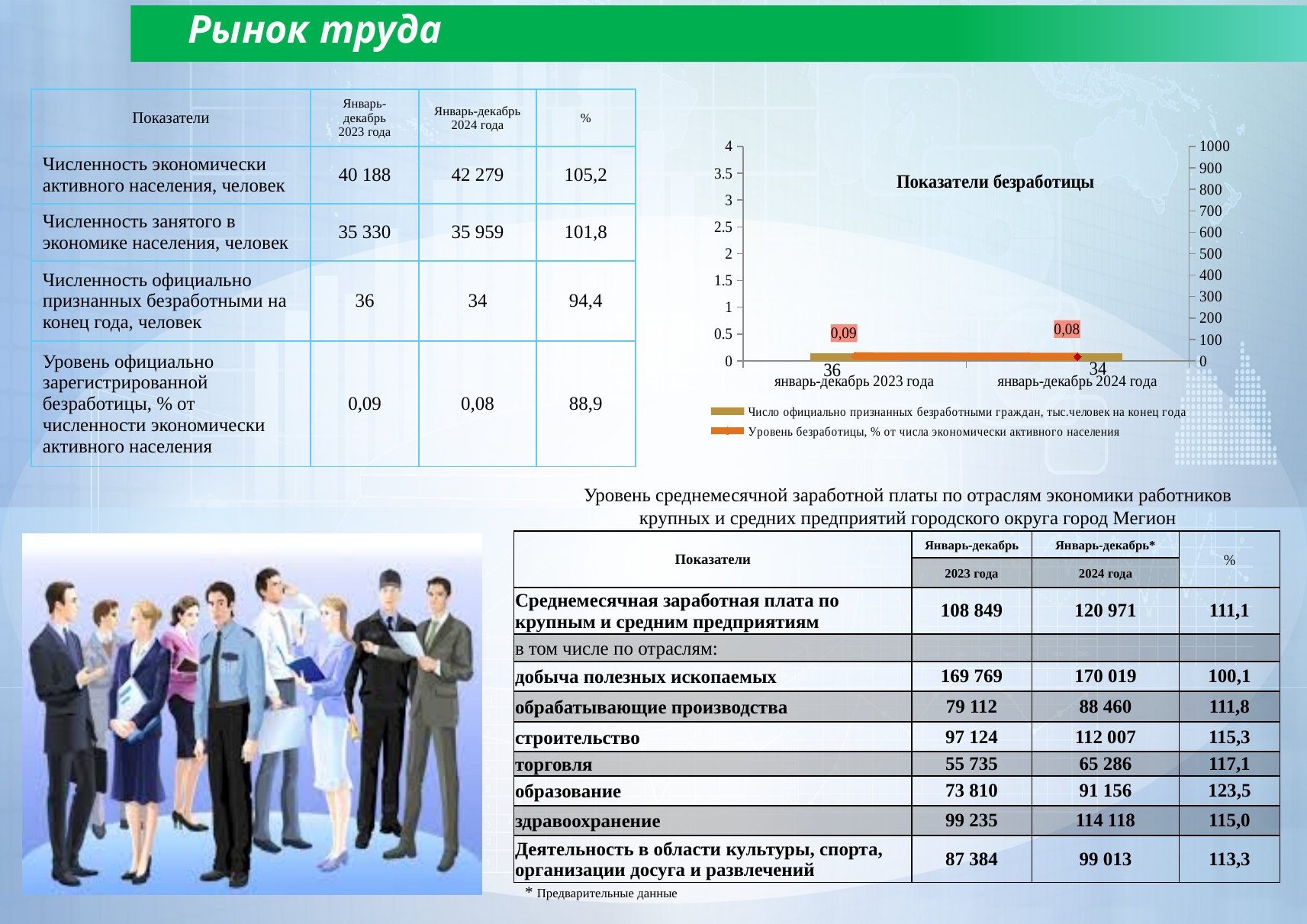
In the chart, which period has the lower value for Уровень безработицы? январь-декабрь 2024 года How many series does the chart legend list? 2 What is the title of the chart on the slide? Показатели безработицы In the chart, what is the difference between the bar values for январь-декабрь 2023 года and январь-декабрь 2024 года? 2 In the chart, what is the value of the bar series (Число официально признанных безработными граждан) for январь-декабрь 2023 года? 36 In the chart, what is the value of Уровень безработицы for январь-декабрь 2023 года? 0,09 In the chart, what is the value of Уровень безработицы for январь-декабрь 2024 года? 0,08 In the chart, does Уровень безработицы rise or fall from январь-декабрь 2023 года to январь-декабрь 2024 года? fall In the chart, which period has the higher value for Число официально признанных безработными граждан? январь-декабрь 2023 года How many categories are shown on the x axis of the chart? 2 Which series in the chart is drawn as a line rather than bars? Уровень безработицы, % от числа экономически активного населения In the chart, what is the value of the bar series (Число официально признанных безработными граждан) for январь-декабрь 2024 года? 34